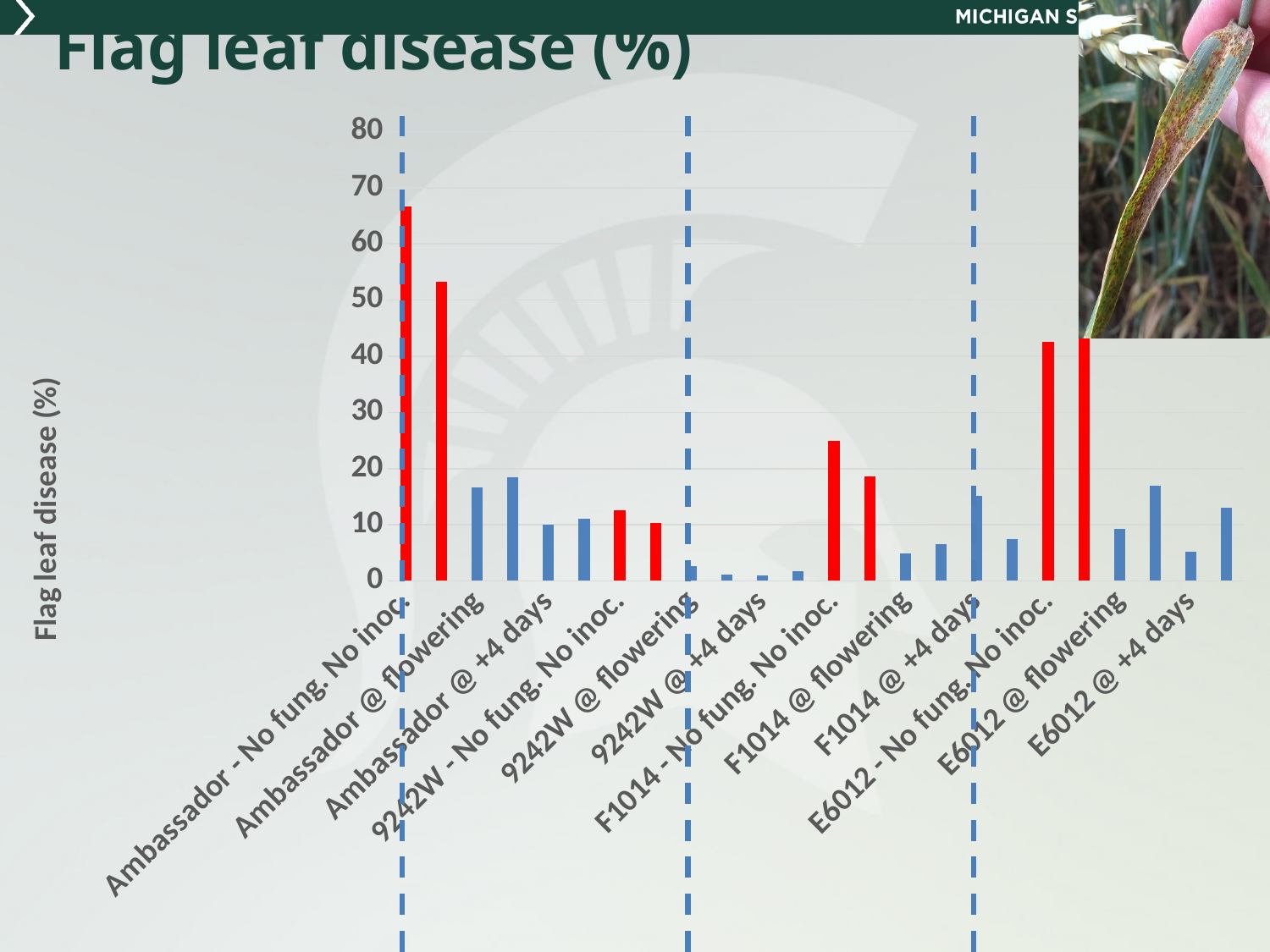
Which category has the shortest bars in the chart? 9242W @ +4 days Is the tallest bar for F1014 - No fung. No inoc. greater or less than 30? less What kind of chart is shown on the slide? bar chart Which has the taller bars: F1014 - No fung. No inoc. or 9242W - No fung. No inoc.? F1014 - No fung. No inoc. Which category has the tallest bar in the chart? Ambassador - No fung. No inoc. Are the bars for E6012 - No fung. No inoc. greater or less than 30? greater Is the tallest bar for Ambassador - No fung. No inoc. greater or less than 60? greater What is the title of the chart? Flag leaf disease (%) Which has the taller bar: Ambassador - No fung. No inoc. or E6012 - No fung. No inoc.? Ambassador - No fung. No inoc. What is the label on the vertical axis of the chart? Flag leaf disease (%)